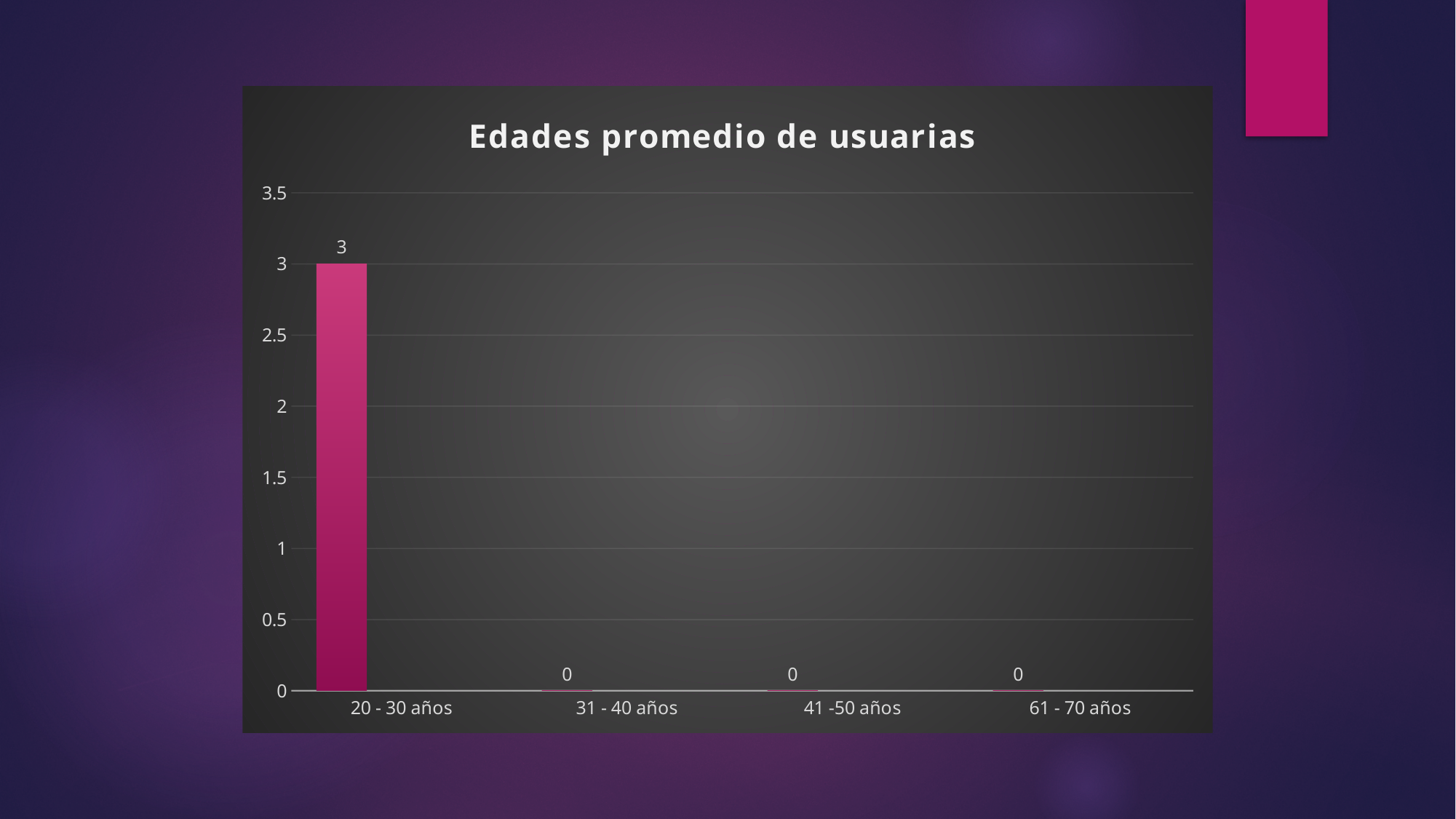
How many categories are shown on the x axis? 4 Which is larger, the value for 20 - 30 años or the value for 31 - 40 años? 20 - 30 años Is the value for 20 - 30 años greater or less than 2? greater What is the highest value shown on the y axis? 3.5 What is the value for 31 - 40 años? 0 What is the difference between the values for 20 - 30 años and 41 -50 años? 3 What is the value for 20 - 30 años? 3 Which category has the highest value? 20 - 30 años What kind of chart is shown on the slide? bar chart How many categories have a value of 0? 3 What is the title of the chart? Edades promedio de usuarias What is the value for 61 - 70 años? 0